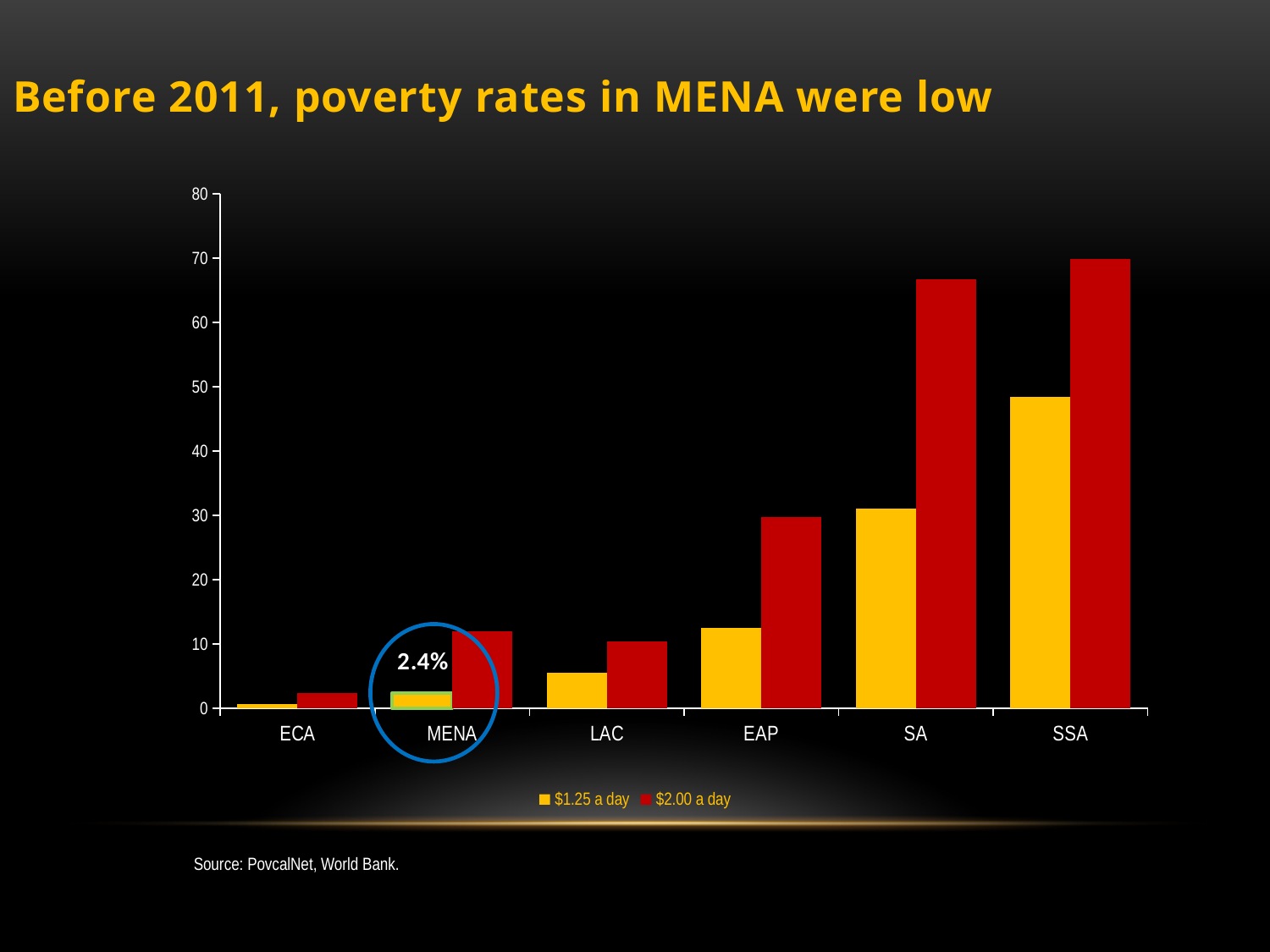
Which region has the highest $1.25 a day poverty rate? SSA How many series does the legend list? 2 What is the $1.25 a day poverty rate shown for MENA? 2.4% Which region has the lowest $2.00 a day poverty rate? ECA Is the $2.00 a day value for LAC greater or less than 20? less Which has the larger $2.00 a day poverty rate, SA or EAP? SA How many regions are shown on the x axis of the chart? 6 Which region is circled on the chart? MENA What kind of chart is shown on the slide? Bar chart Is the $1.25 a day value for SA greater or less than 40? less Which region has the lowest $1.25 a day poverty rate? ECA Is the $2.00 a day value for SSA greater or less than 60? greater